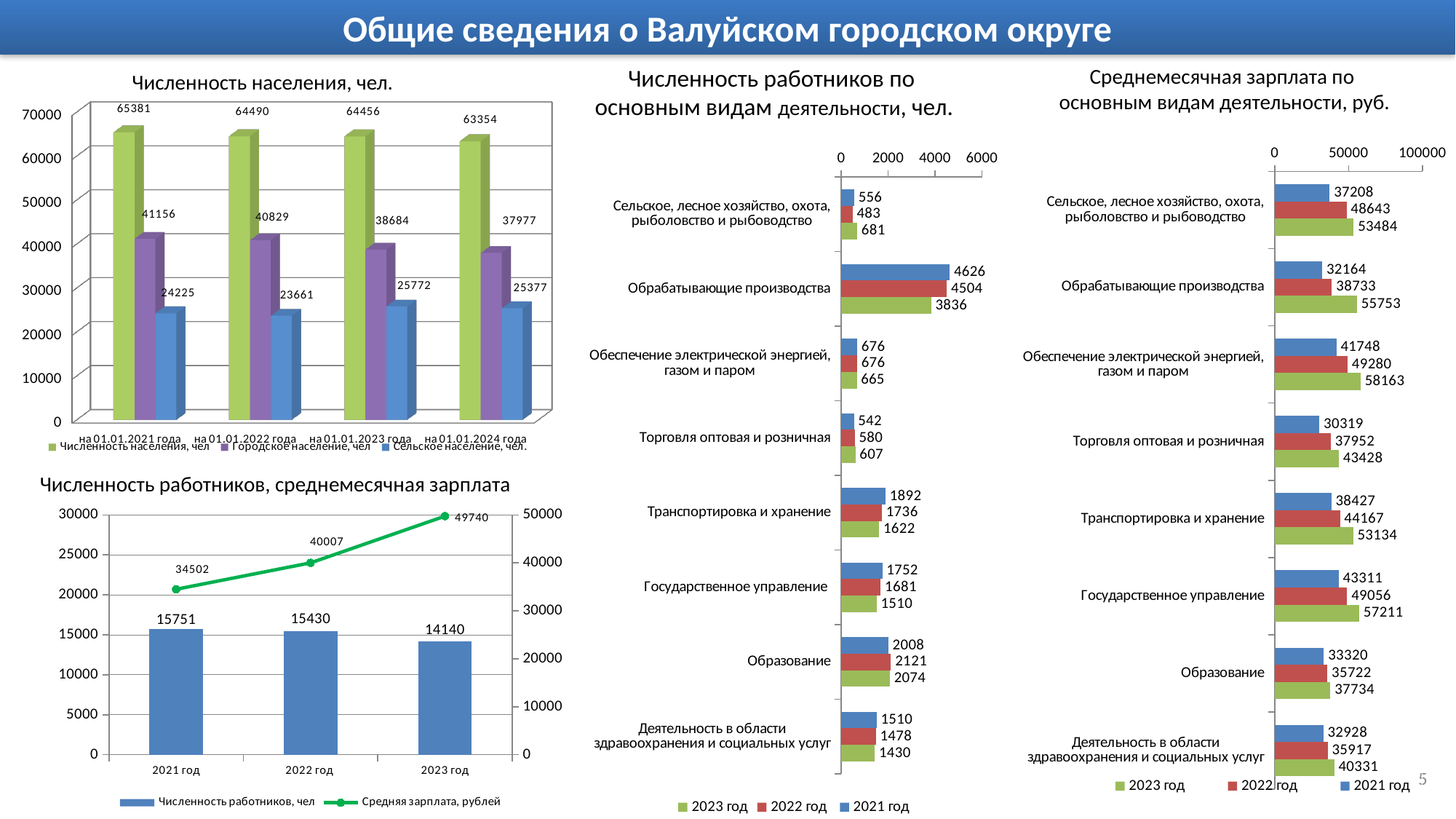
In the chart 'Численность работников, среднемесячная зарплата', how many series does the legend list? 2 In the chart 'Численность работников, среднемесячная зарплата', what is the value of 'Средняя зарплата, рублей' for 2023 год? 49740 What kind of chart is 'Среднемесячная зарплата по основным видам деятельности, руб.'? bar chart In the chart 'Численность населения, чел.', what is the difference between 'Городское население, чел' and 'Сельское население, чел' on 01.01.2021? 16931 In the chart 'Численность работников по основным видам деятельности, чел.', how many categories are shown? 8 In the chart 'Численность населения, чел.', does the total population rise or fall from 01.01.2021 to 01.01.2024? fall In the chart 'Численность работников по основным видам деятельности, чел.', what is the value for 'Обрабатывающие производства' in 2023 год? 3836 In the chart 'Среднемесячная зарплата по основным видам деятельности, руб.', what is the value for 'Государственное управление' in 2023 год? 57211 In the chart 'Численность работников по основным видам деятельности, чел.', which category has the highest value in 2021 год? Обрабатывающие производства In the chart 'Численность населения, чел.', what is the value of 'Численность населения, чел' on 01.01.2024? 63354 In the chart 'Численность работников, среднемесячная зарплата', which year has the lowest 'Численность работников, чел'? 2023 год In the chart 'Среднемесячная зарплата по основным видам деятельности, руб.', which is larger in 2022 год: 'Образование' or 'Транспортировка и хранение'? Транспортировка и хранение